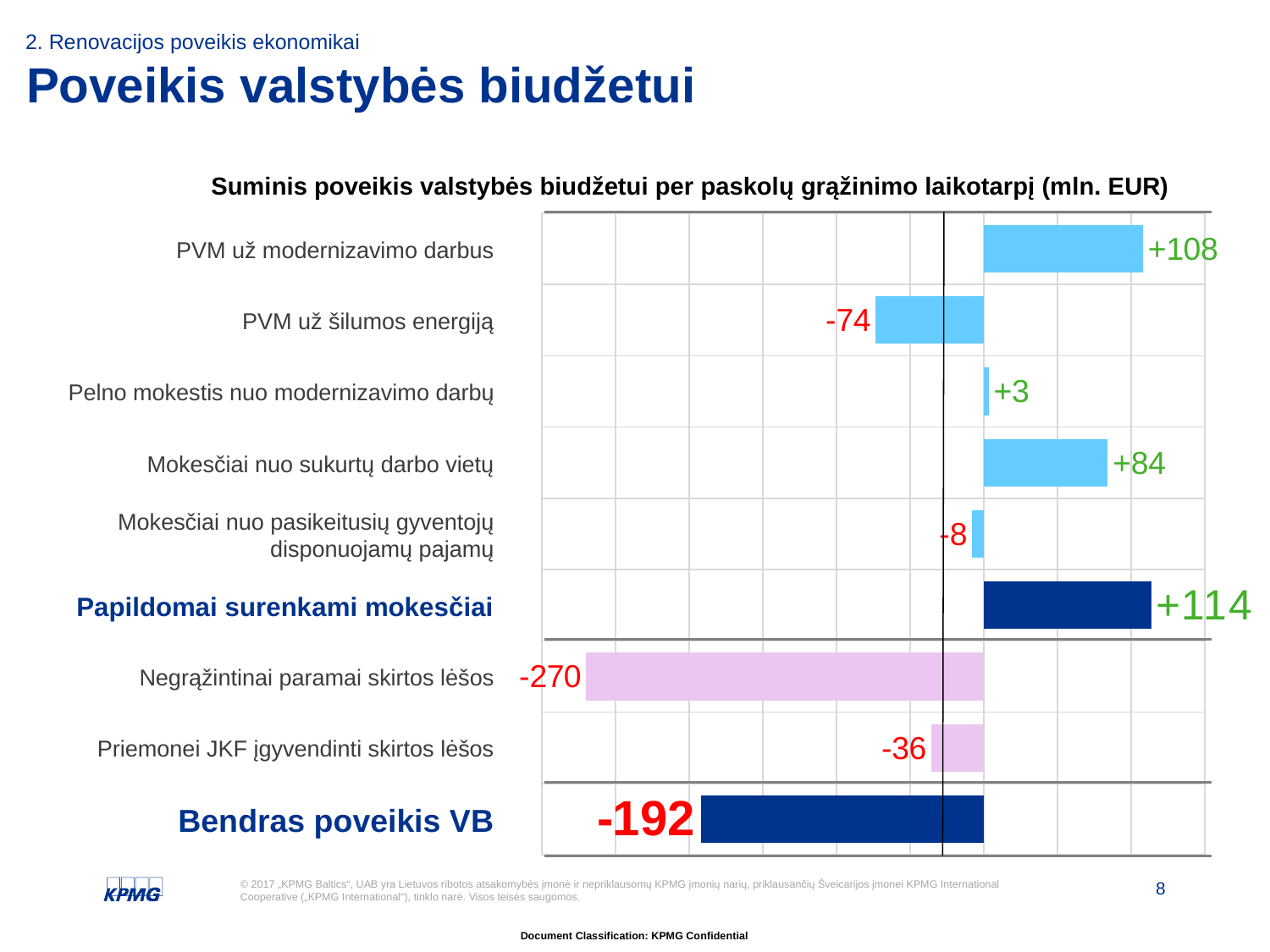
What is the title of the chart? Suminis poveikis valstybės biudžetui per paskolų grąžinimo laikotarpį (mln. EUR) What is the difference between the values for "PVM už modernizavimo darbus" and "Mokesčiai nuo sukurtų darbo vietų"? 24 What kind of chart is shown on the slide? Bar chart What is the value for "Negrąžintinai paramai skirtos lėšos"? -270 Which category has the highest value? Papildomai surenkami mokesčiai Which is larger, the value for "Pelno mokestis nuo modernizavimo darbų" or the value for "Mokesčiai nuo sukurtų darbo vietų"? Mokesčiai nuo sukurtų darbo vietų What is the value for "PVM už šilumos energiją"? -74 Which category has the lowest value? Negrąžintinai paramai skirtos lėšos What is the value for "Papildomai surenkami mokesčiai"? +114 What is the value for "PVM už modernizavimo darbus"? +108 What is the value for "Bendras poveikis VB"? -192 How many categories are shown in the chart? 9